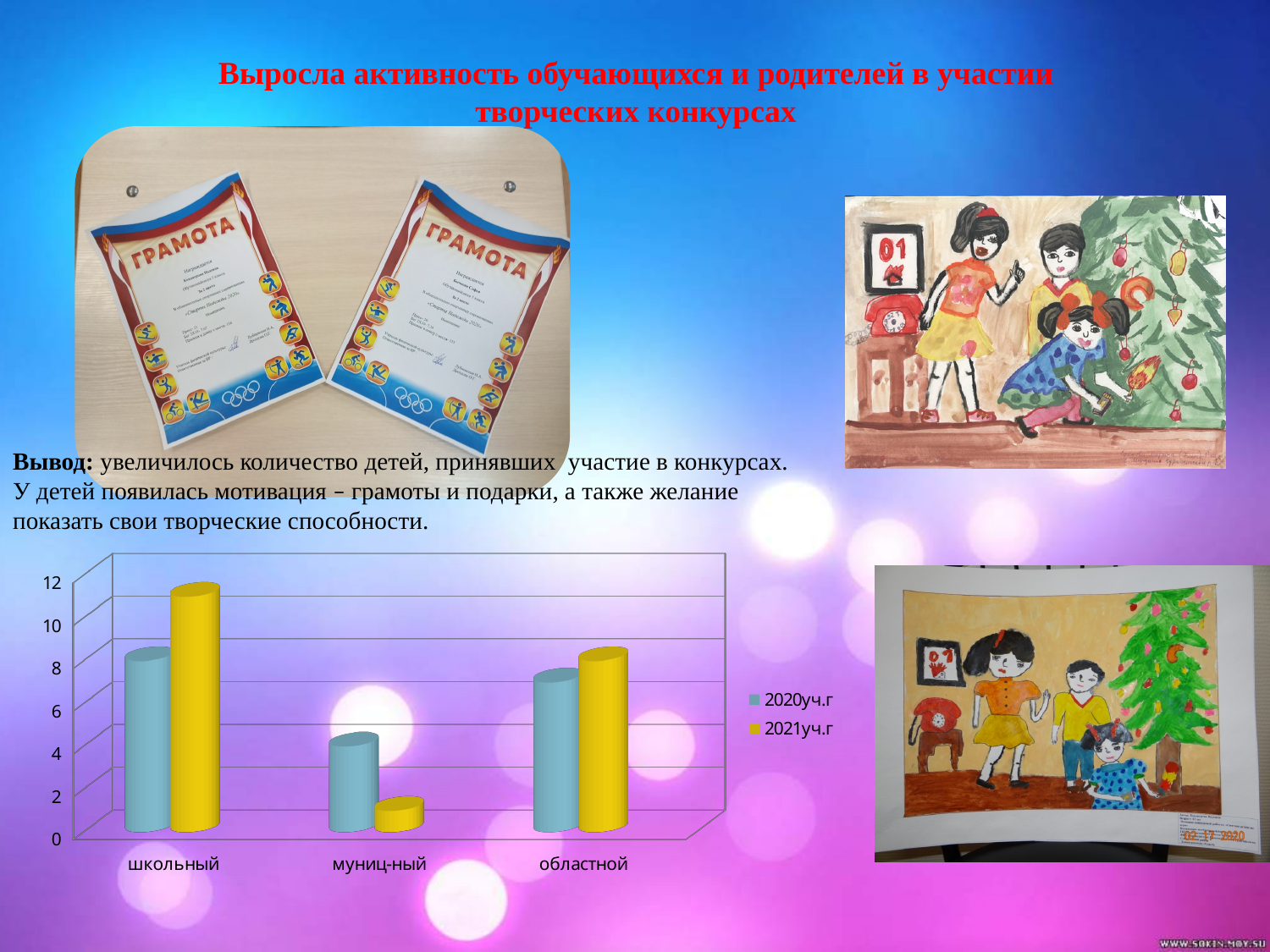
For the школьный category, which series has the larger value, 2020уч.г or 2021уч.г? 2021уч.г Which category has the highest value for the 2021уч.г series? школьный How many series does the chart legend list? 2 Is the value for муниц-ный in the 2021уч.г series greater or less than 2? less Which category has the lowest value for the 2020уч.г series? муниц-ный What kind of chart is shown on the slide? bar chart Which category has the highest value for the 2020уч.г series? школьный Which colour represents the 2021уч.г series in the chart? yellow For the муниц-ный category, which series has the larger value, 2020уч.г or 2021уч.г? 2020уч.г Which category has the lowest value for the 2021уч.г series? муниц-ный How many categories are shown on the x axis of the chart? 3 Is the value for школьный in the 2021уч.г series greater or less than 10? greater